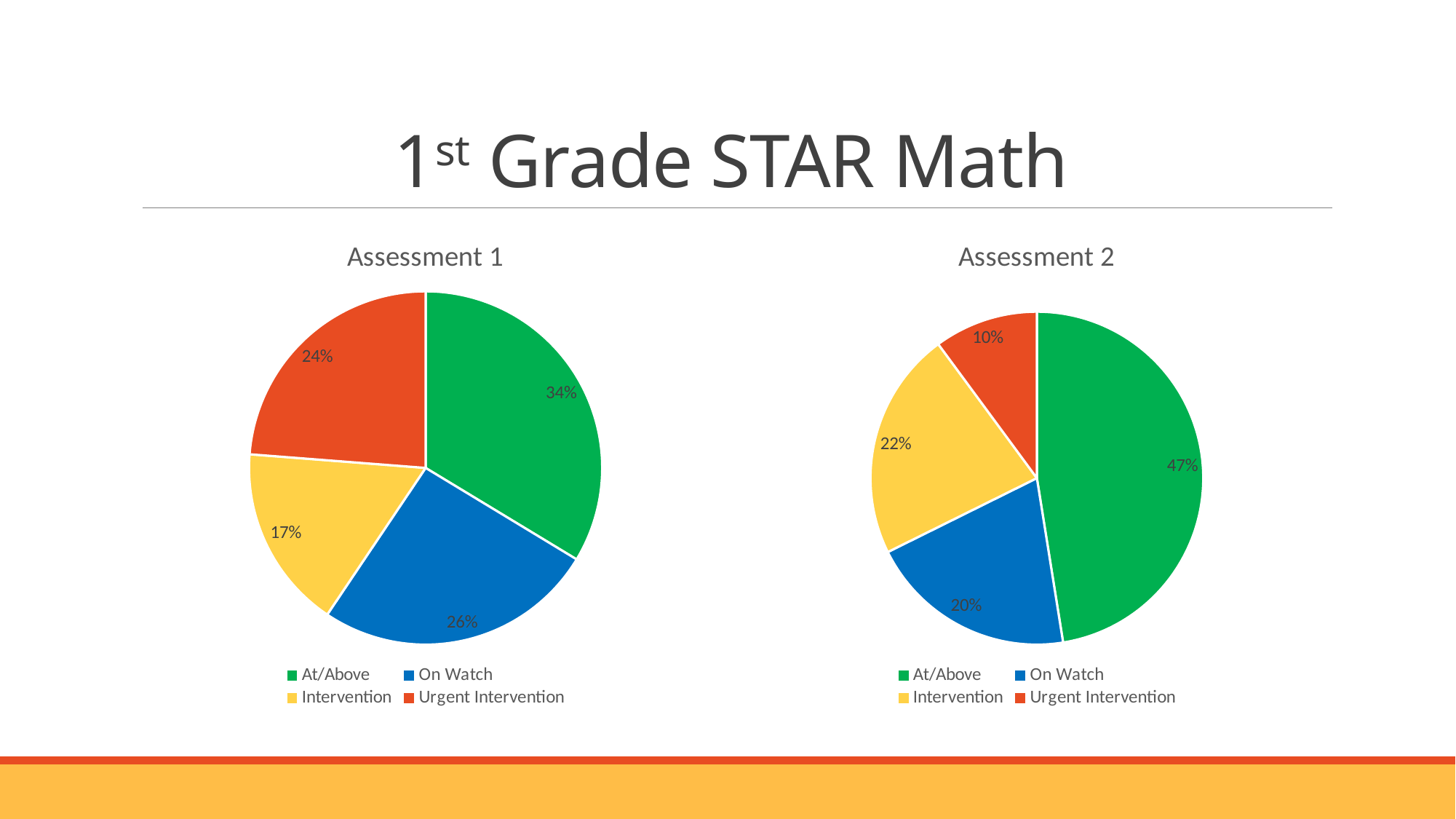
In the Assessment 2 chart, which category has the largest slice? At/Above In the Assessment 1 chart, what percentage is shown for At/Above? 34% In the Assessment 2 chart, which category has the smallest slice? Urgent Intervention In the Assessment 1 chart, which category has the smallest slice? Intervention How many slices does the Assessment 1 pie chart have? 4 What is the difference between the At/Above percentages in the Assessment 2 chart and the Assessment 1 chart? 13% In the Assessment 1 chart, which is larger, On Watch or Urgent Intervention? On Watch How many entries does the legend of the Assessment 2 chart list? 4 What type of chart is used for Assessment 2? Pie chart In the Assessment 2 chart, what percentage is shown for Intervention? 22% In the Assessment 2 chart, what percentage is shown for At/Above? 47% In the Assessment 1 chart, what percentage is shown for Urgent Intervention? 24%